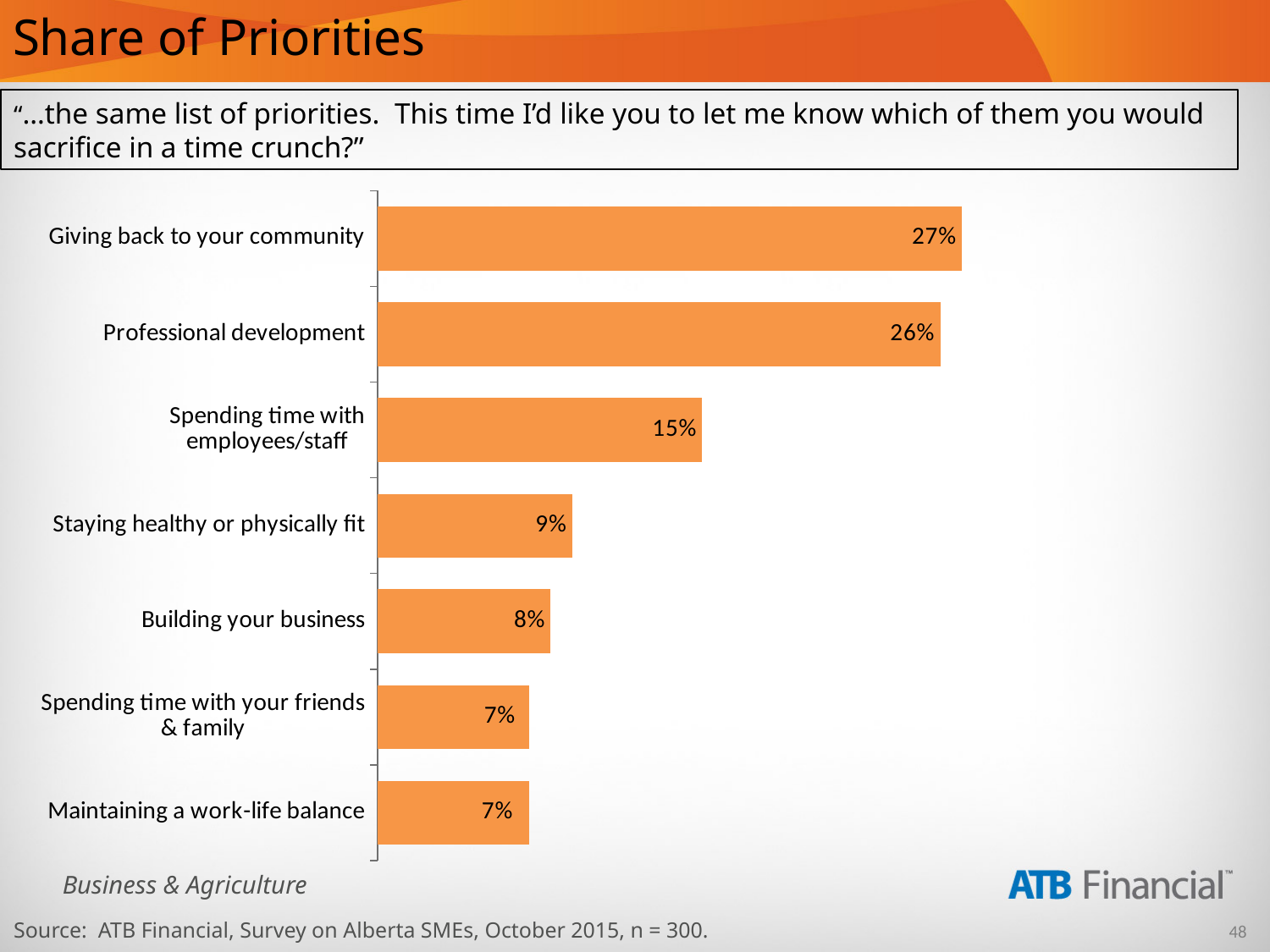
What kind of chart is shown on the slide? Bar chart Which two priorities share the same value of 7%? Spending time with your friends & family; Maintaining a work-life balance How many priorities are shown in the chart? 7 Which is larger: the value for Staying healthy or physically fit or the value for Building your business? Staying healthy or physically fit Which priority has the highest share of respondents willing to sacrifice it? Giving back to your community What percentage of respondents would sacrifice giving back to your community in a time crunch? 27% What is the difference between the values for Spending time with employees/staff and Staying healthy or physically fit? 6% What is the value shown for Professional development? 26% What is the value shown for Building your business? 8% What colour are the bars in the chart? Orange What is the value shown for Spending time with employees/staff? 15% What is the difference between the values for Giving back to your community and Professional development? 1%